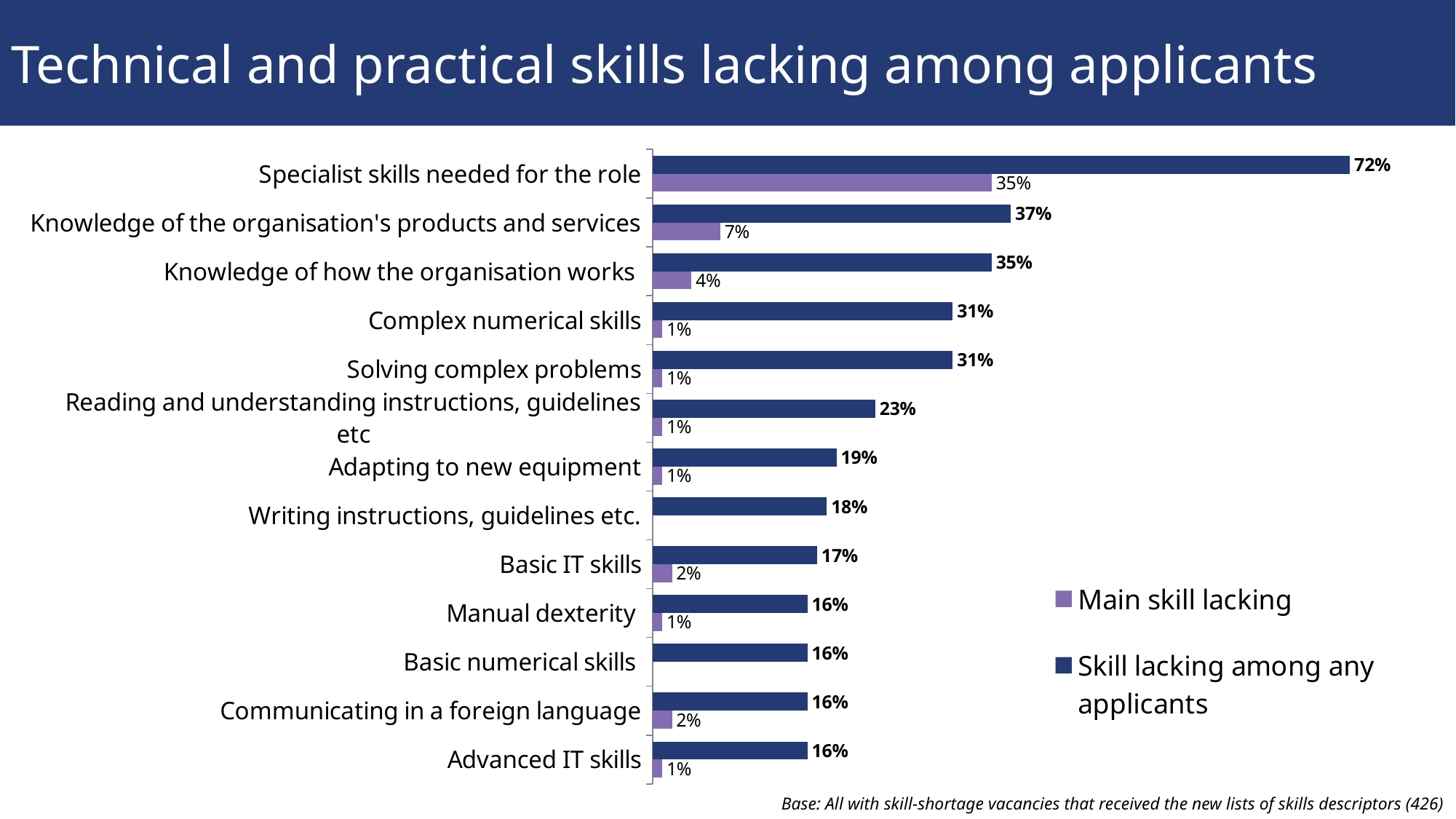
Which category has the highest value in the 'Skill lacking among any applicants' series? Specialist skills needed for the role What is the 'Skill lacking among any applicants' value for 'Reading and understanding instructions, guidelines etc'? 23% What percentage is shown for 'Specialist skills needed for the role' in the 'Skill lacking among any applicants' series? 72% How many series does the legend list? 2 What type of chart is shown on the slide? Bar chart How many skill categories are listed on the chart? 13 In the 'Skill lacking among any applicants' series, which is larger: 'Knowledge of the organisation's products and services' or 'Knowledge of how the organisation works'? Knowledge of the organisation's products and services What colour represents the 'Main skill lacking' series in the legend? Purple For 'Specialist skills needed for the role', what is the difference between the 'Skill lacking among any applicants' value and the 'Main skill lacking' value? 37 percentage points For 'Knowledge of the organisation's products and services', how much larger is the 'Skill lacking among any applicants' value than the 'Main skill lacking' value? 30 percentage points What is the 'Main skill lacking' value for 'Knowledge of the organisation's products and services'? 7% What is the 'Main skill lacking' value for 'Basic IT skills'? 2%